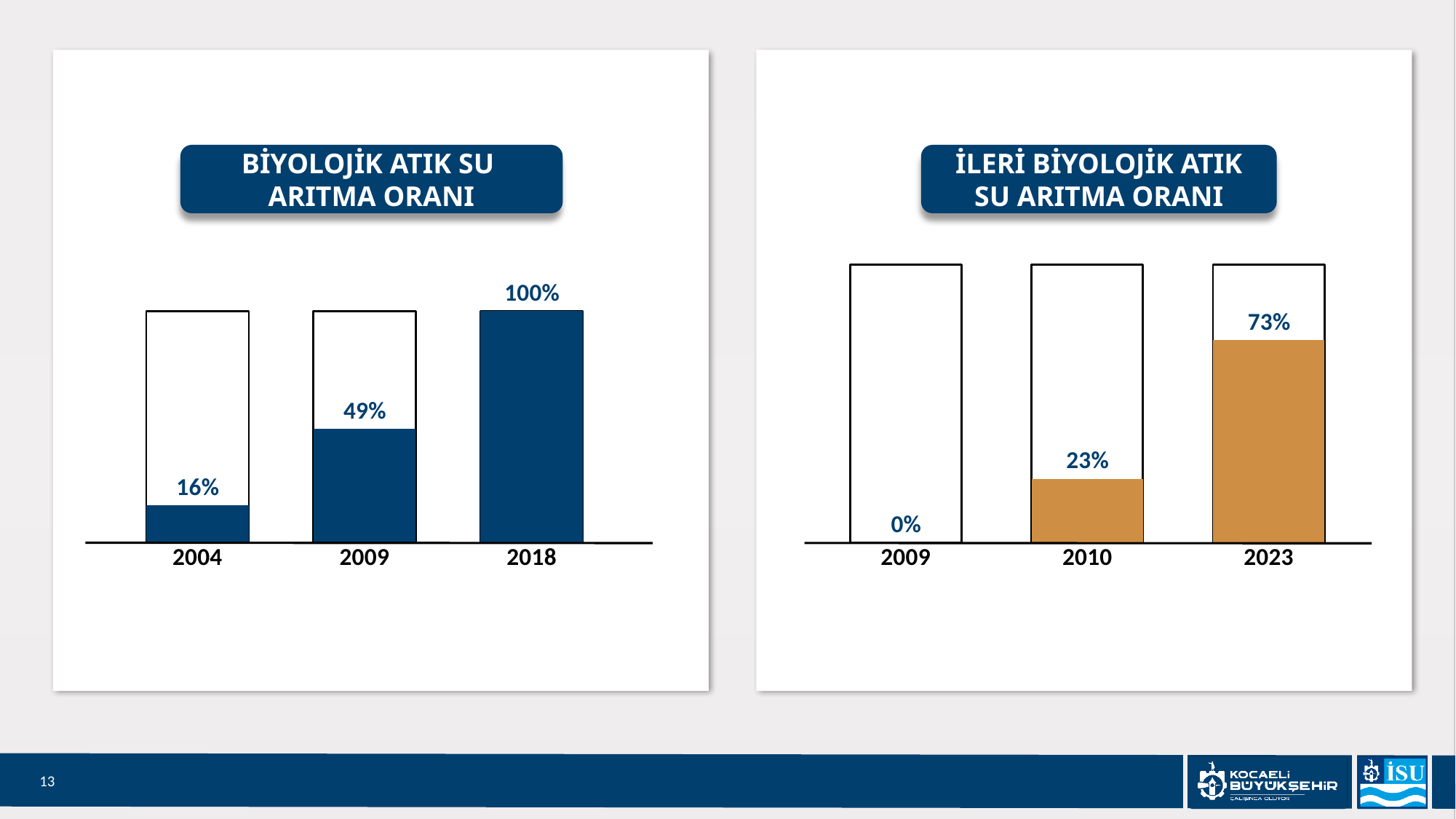
In the 'BİYOLOJİK ATIK SU ARITMA ORANI' chart, what is the difference between the values for 2018 and 2004? 84% In the 'İLERİ BİYOLOJİK ATIK SU ARITMA ORANI' chart, what is the value for 2010? 23% Which is larger: the 2009 value in the 'BİYOLOJİK ATIK SU ARITMA ORANI' chart or the 2010 value in the 'İLERİ BİYOLOJİK ATIK SU ARITMA ORANI' chart? 2009 value in the BİYOLOJİK ATIK SU ARITMA ORANI chart In the 'İLERİ BİYOLOJİK ATIK SU ARITMA ORANI' chart, what is the difference between the values for 2023 and 2010? 50% In the 'BİYOLOJİK ATIK SU ARITMA ORANI' chart, how many years are shown? 3 In the 'BİYOLOJİK ATIK SU ARITMA ORANI' chart, which year has the highest value? 2018 In the 'BİYOLOJİK ATIK SU ARITMA ORANI' chart, do the values rise or fall from 2004 to 2018? rise What kind of chart is the 'İLERİ BİYOLOJİK ATIK SU ARITMA ORANI' chart? bar chart In the 'İLERİ BİYOLOJİK ATIK SU ARITMA ORANI' chart, which year has the lowest value? 2009 In the 'BİYOLOJİK ATIK SU ARITMA ORANI' chart, what is the value for 2004? 16% In the 'İLERİ BİYOLOJİK ATIK SU ARITMA ORANI' chart, what is the value for 2023? 73% In the 'BİYOLOJİK ATIK SU ARITMA ORANI' chart, what is the value for 2009? 49%